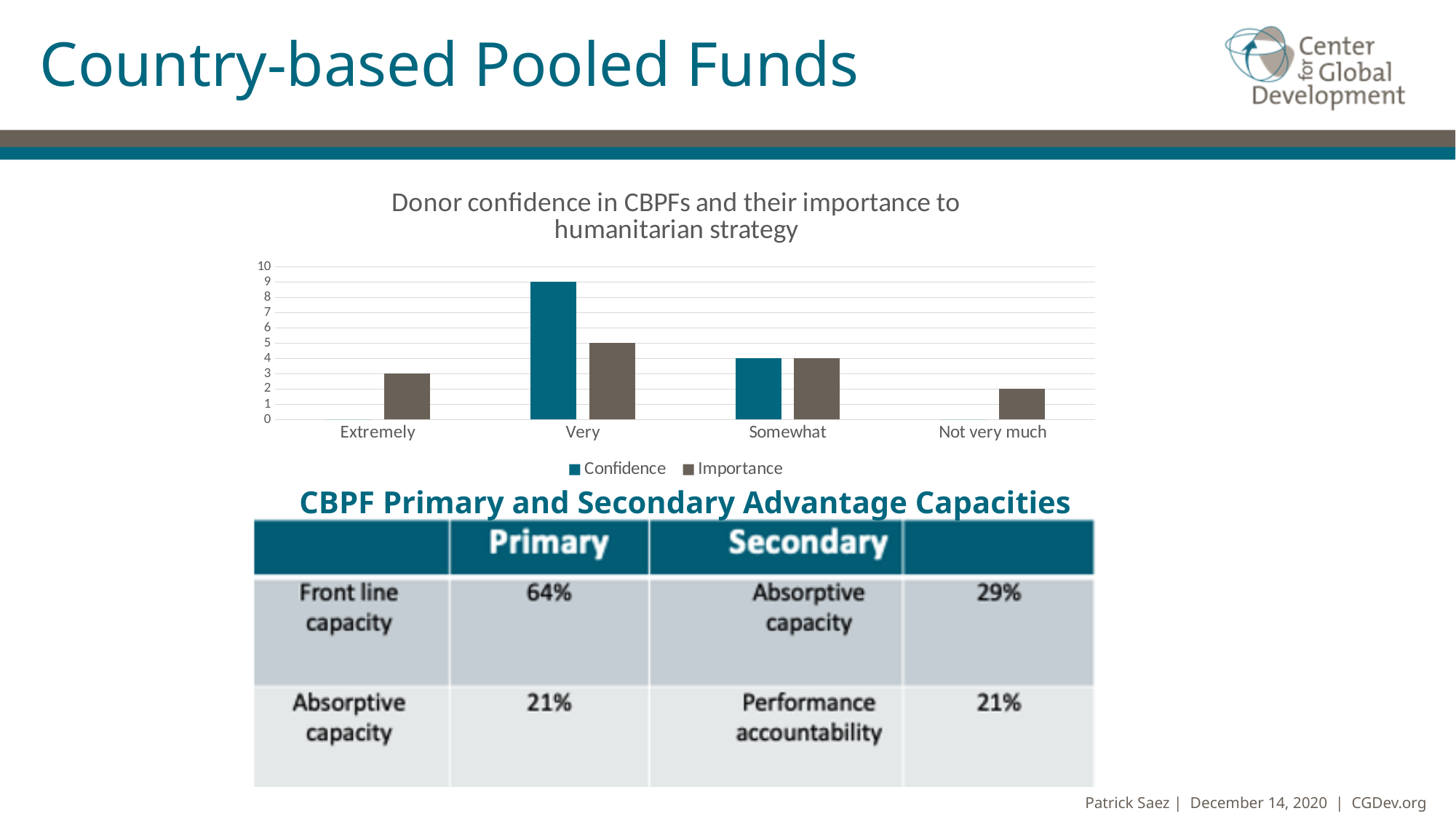
In the bar chart, which is larger for 'Very': the Confidence value or the Importance value? Confidence In the bar chart, what is the Importance value for 'Extremely'? 3 How many categories are shown on the x axis of the bar chart? 4 In the bar chart, what is the Importance value for 'Not very much'? 2 How many series does the legend of the bar chart list? 2 In the bar chart, is the Confidence value for 'Very' greater or less than 8? greater In the bar chart, what is the Confidence value for 'Very'? 9 In the bar chart, what is the Importance value for 'Very'? 5 In the bar chart, which series is shown in teal? Confidence In the bar chart, which category has the highest Confidence value? Very What kind of chart is shown under the title 'Donor confidence in CBPFs and their importance to humanitarian strategy'? bar chart In the bar chart, which category has the lowest Importance value? Not very much